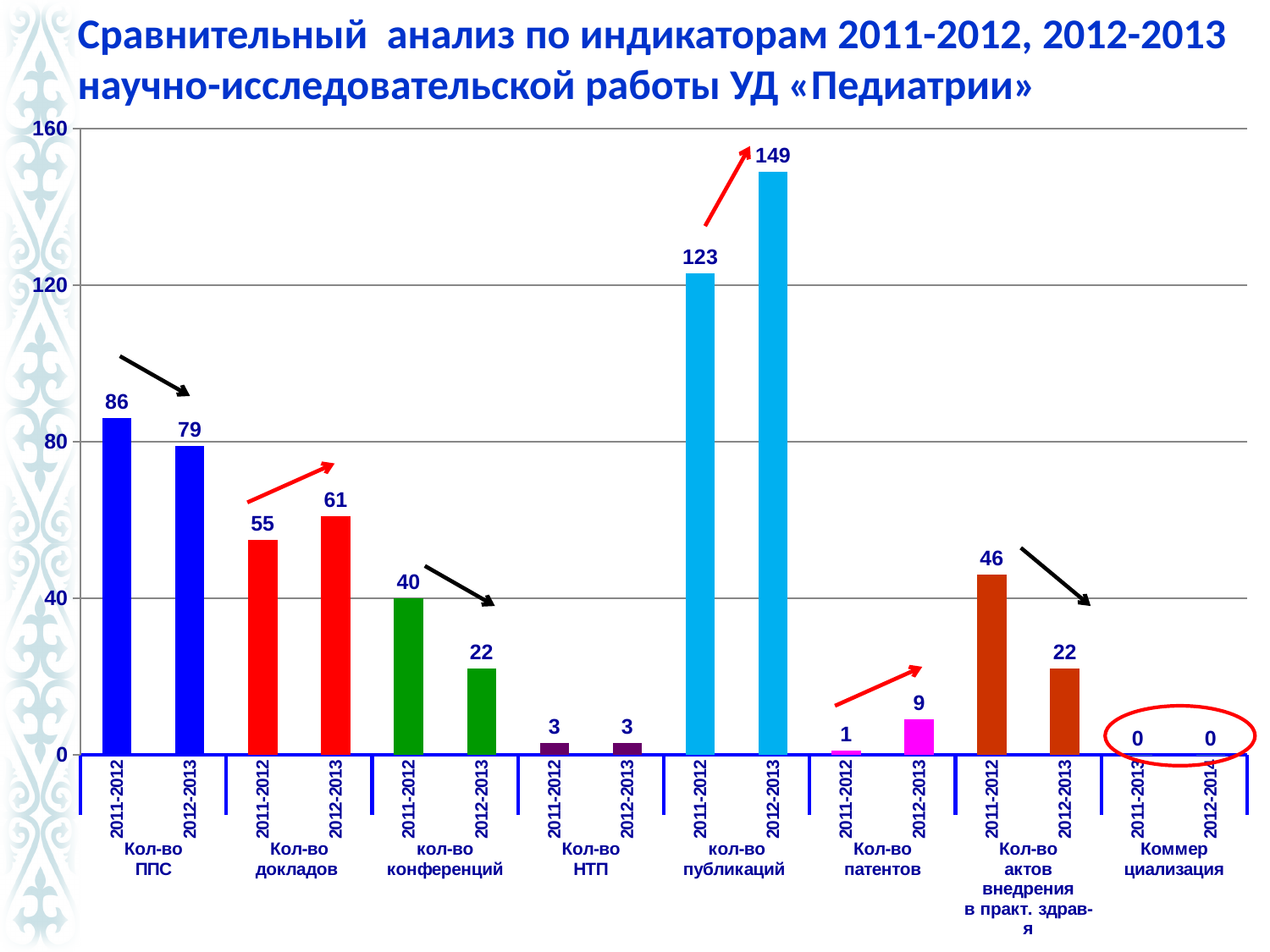
What value is shown for both bars in the 'Кол-во НТП' group? 3 Is the 2011-2012 value for 'кол-во публикаций' greater or less than 120? greater Which bar has the highest value on the chart? 2012-2013 in кол-во публикаций (149) What is the difference between the 2011-2012 and 2012-2013 values in the 'Кол-во актов внедрения в практ. здрав-я' group? 24 What kind of chart is shown on the slide? bar chart What is the value for 2012-2013 in the 'кол-во публикаций' group? 149 What is the difference between the 2012-2013 and 2011-2012 values in the 'кол-во публикаций' group? 26 What is the value for 2011-2012 in the 'Кол-во ППС' group? 86 What is the value for 2012-2013 in the 'кол-во конференций' group? 22 In the 'Кол-во докладов' group, which is larger: the 2011-2012 value or the 2012-2013 value? 2012-2013 How many indicator groups are shown on the x axis? 8 What is the value for 2011-2012 in the 'Кол-во патентов' group? 1